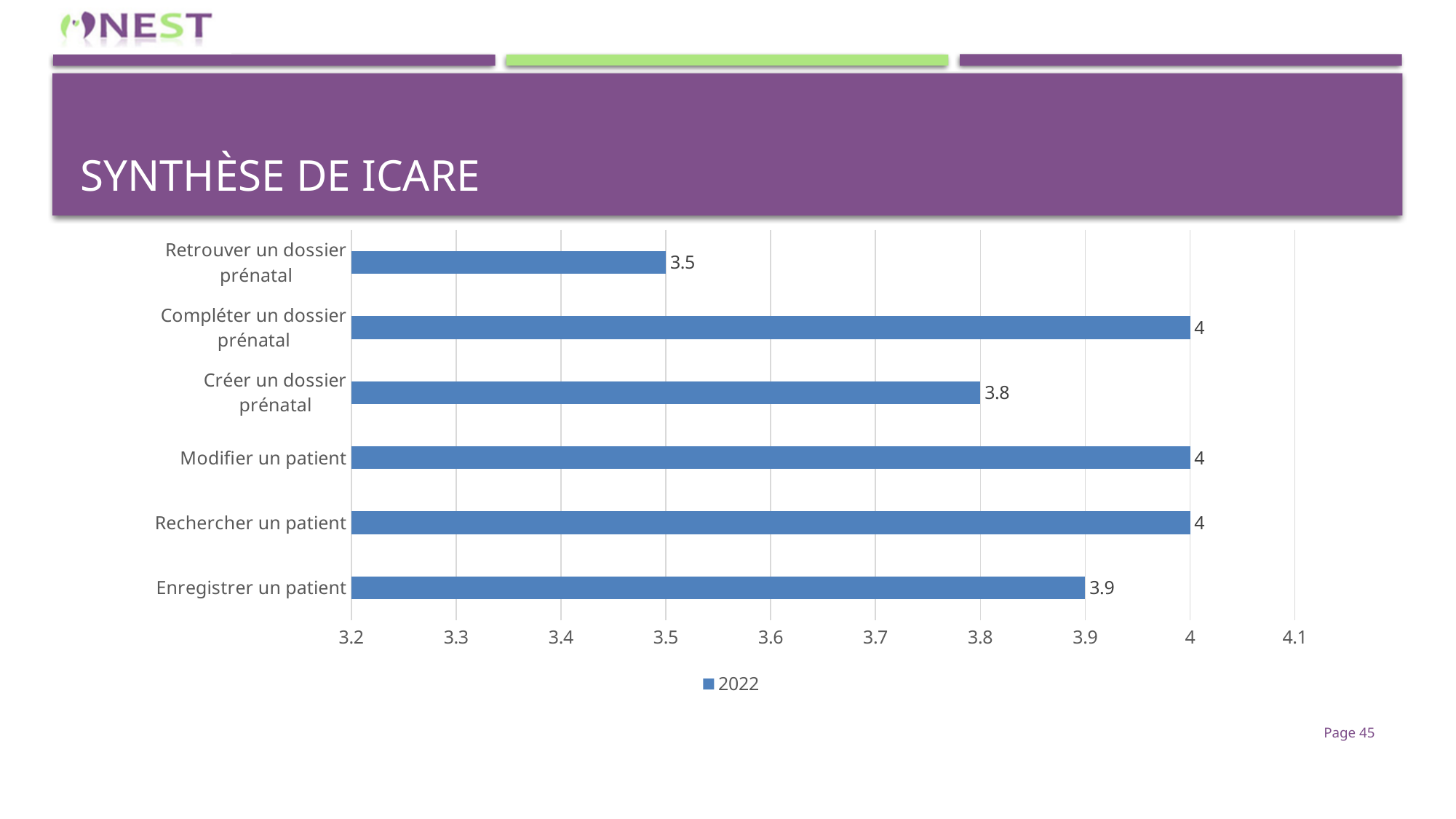
What kind of chart is shown on the slide? bar chart What is the difference between the values for Enregistrer un patient and Retrouver un dossier prénatal? 0.4 How many categories are shown in the chart? 6 Is the value for Retrouver un dossier prénatal greater or less than 3.7? less Which category has the lowest value? Retrouver un dossier prénatal Which is larger, the value for Créer un dossier prénatal or the value for Enregistrer un patient? Enregistrer un patient What is the value for Créer un dossier prénatal? 3.8 What is the value for Compléter un dossier prénatal? 4 What is the value for Retrouver un dossier prénatal? 3.5 What is the value for Enregistrer un patient? 3.9 What is the difference between the values for Modifier un patient and Créer un dossier prénatal? 0.2 How many series does the legend list? 1